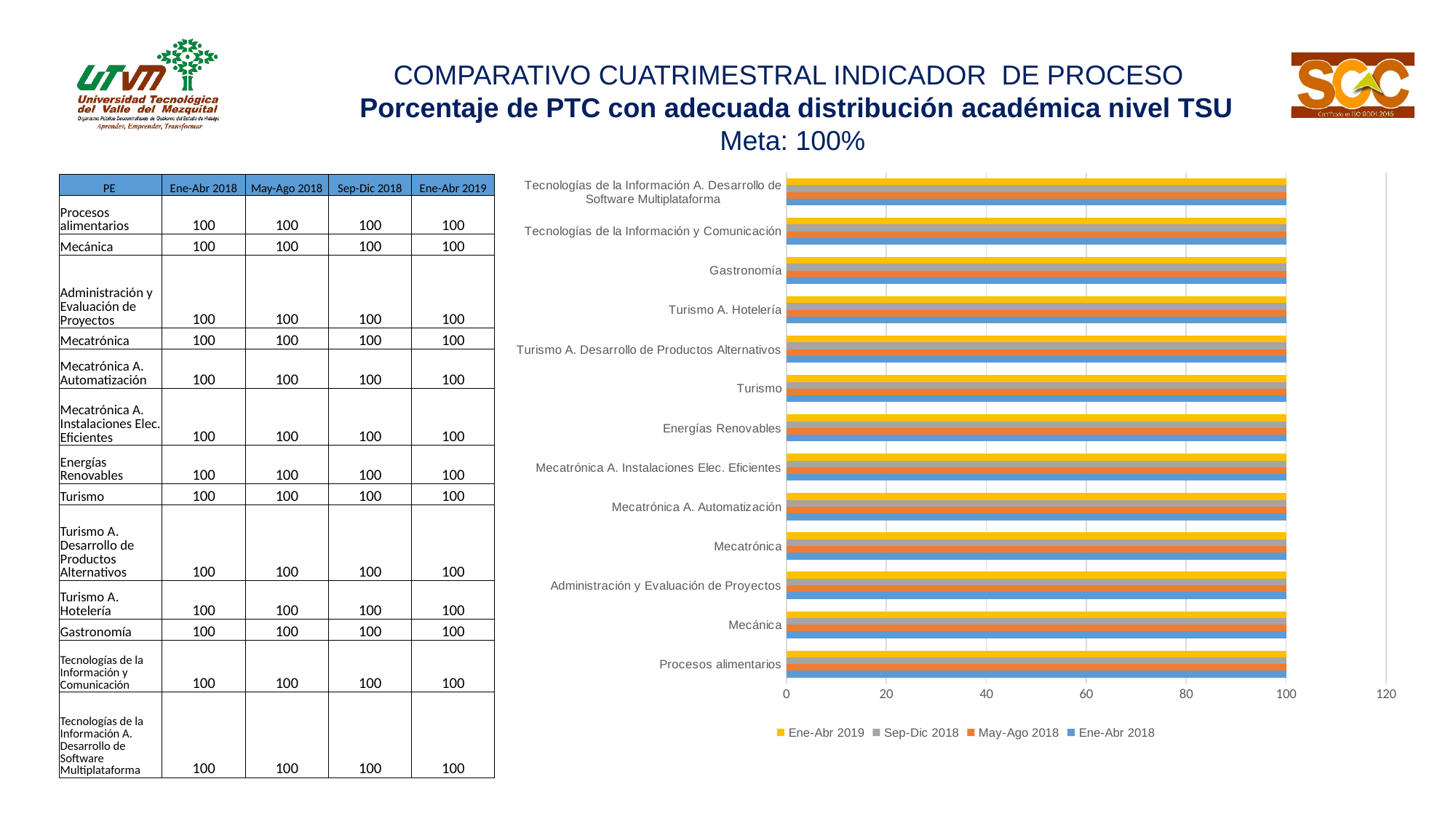
How many series does the chart legend list? 4 Is the value for Turismo A. Hotelería in the Sep-Dic 2018 series greater or less than 120? less How many categories (programs) are plotted on the chart? 13 What is the value for Mecánica in the Sep-Dic 2018 series? 100 What kind of chart is shown on the slide? bar chart What is the highest value shown on the chart's horizontal axis? 120 Is the value for Energías Renovables in the Ene-Abr 2019 series greater or less than 80? greater Which series is listed first in the chart legend? Ene-Abr 2019 What is the value for Procesos alimentarios in the Ene-Abr 2018 series? 100 What is the value for Gastronomía in the Ene-Abr 2019 series? 100 What is the difference between the Ene-Abr 2019 value for Mecatrónica and the Ene-Abr 2018 value for Mecatrónica? 0 What is the value for Turismo in the May-Ago 2018 series? 100